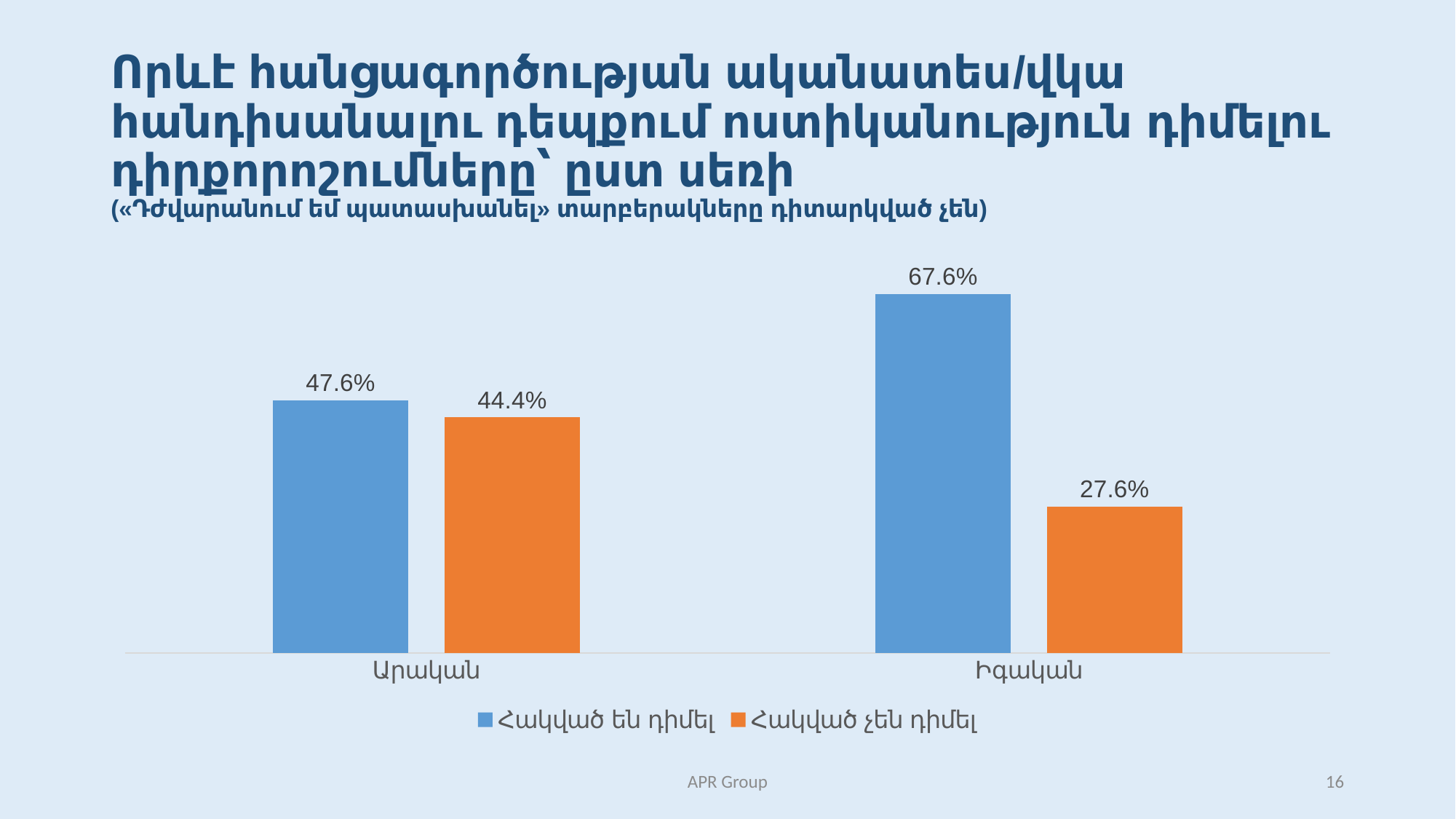
How many series does the legend list? 2 What is the difference between the Հակված են դիմել values for Իգական and Արական? 20 percentage points How many categories are shown on the x axis? 2 What is the value for Հակված չեն դիմել in the Արական category? 44.4% What kind of chart is shown on the slide? Bar chart What is the difference between Հակված են դիմել and Հակված չեն դիմել in the Իգական category? 40 percentage points Which is larger in the Արական category: Հակված են դիմել or Հակված չեն դիմել? Հակված են դիմել Which category has the highest value for Հակված են դիմել? Իգական Which category has the lowest value for Հակված չեն դիմել? Իգական What is the value for Հակված են դիմել in the Արական category? 47.6% What is the value for Հակված չեն դիմել in the Իգական category? 27.6% What is the value for Հակված են դիմել in the Իգական category? 67.6%